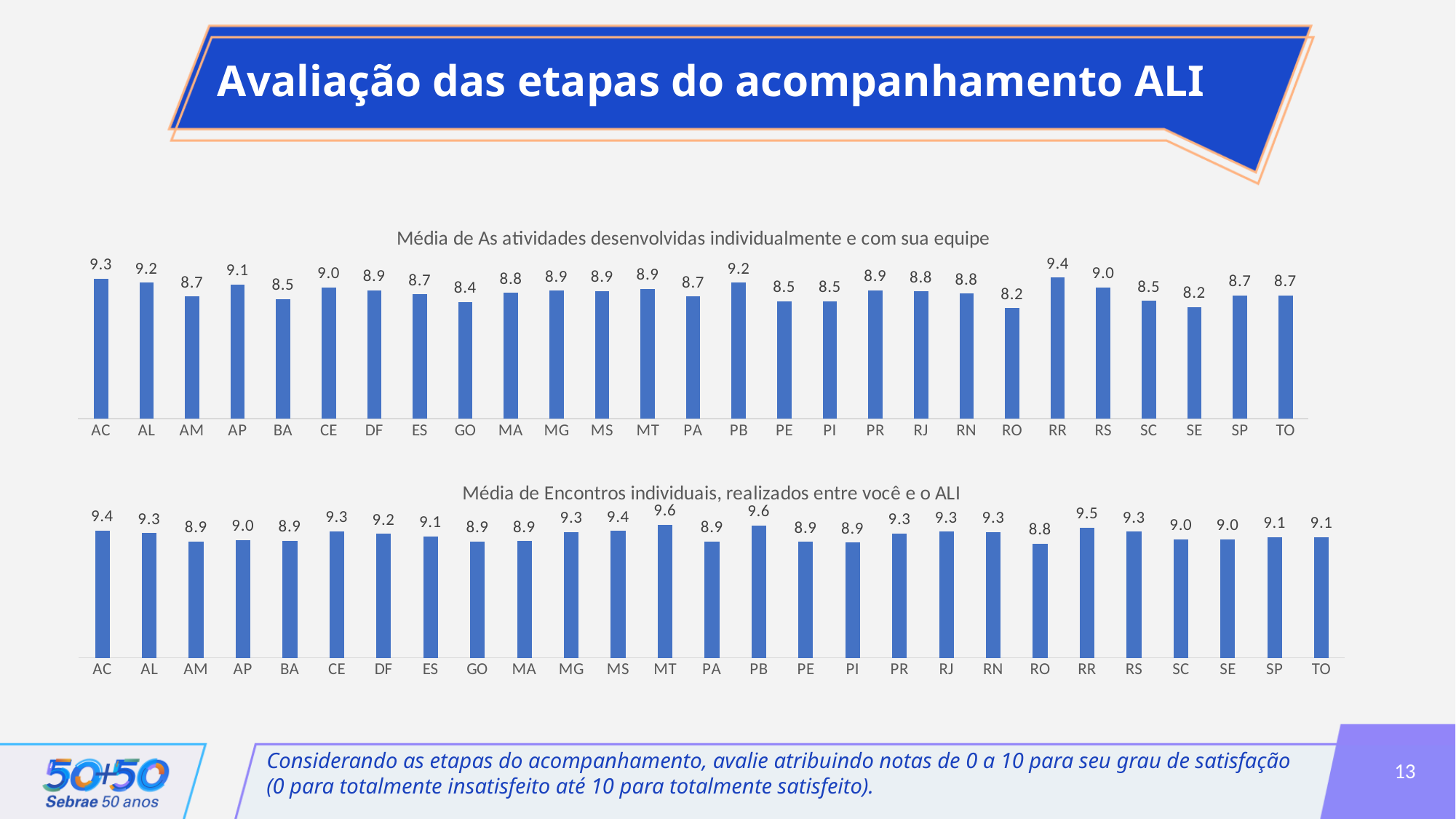
In the bottom chart (Média de Encontros individuais, realizados entre você e o ALI), which is larger, the value for DF or the value for SC? DF In the bottom chart (Média de Encontros individuais, realizados entre você e o ALI), which state has the lowest value? RO In the top chart (Média de As atividades desenvolvidas individualmente e com sua equipe), how many states are shown? 27 What type of chart is the top chart on the slide? Bar chart In the bottom chart (Média de Encontros individuais, realizados entre você e o ALI), what is the value for SP? 9.1 In the bottom chart (Média de Encontros individuais, realizados entre você e o ALI), what is the value for MT? 9.6 In the top chart (Média de As atividades desenvolvidas individualmente e com sua equipe), which is larger, the value for PB or the value for PE? PB What is the title of the bottom chart? Média de Encontros individuais, realizados entre você e o ALI In the top chart (Média de As atividades desenvolvidas individualmente e com sua equipe), what is the value for AC? 9.3 In the bottom chart (Média de Encontros individuais, realizados entre você e o ALI), what is the difference between the values for RR and AM? 0.6 In the top chart (Média de As atividades desenvolvidas individualmente e com sua equipe), which state has the highest value? RR In the top chart (Média de As atividades desenvolvidas individualmente e com sua equipe), what is the difference between the values for RR and RO? 1.2